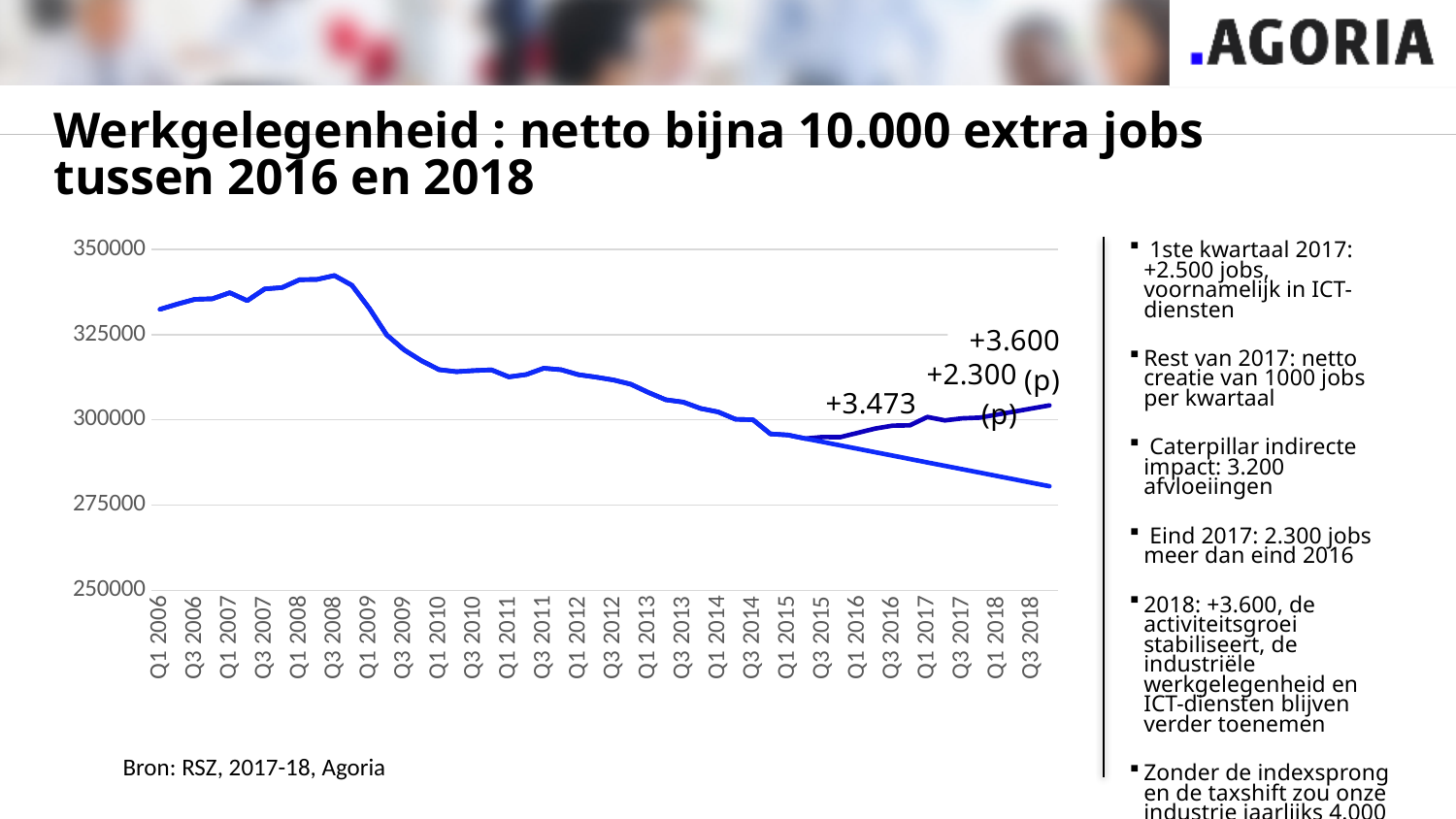
What annotation is shown on the chart for 2018? +3.600 (p) How many lines are plotted on the chart? 2 Is the value of the lower (declining) line at Q3 2018 greater or less than 300000? less Is the value for Q1 2010 greater or less than 325000? less Do the values rise or fall between Q1 2006 and Q3 2008? rise Is the value for Q1 2006 greater or less than 325000? greater How many quarter labels are shown along the x axis of the chart? 26 What kind of chart is shown on the slide? line chart At which quarter does the line reach its highest point? Q3 2008 What source is cited below the chart? Bron: RSZ, 2017-18, Agoria Do the values rise or fall between Q3 2008 and Q3 2015? fall